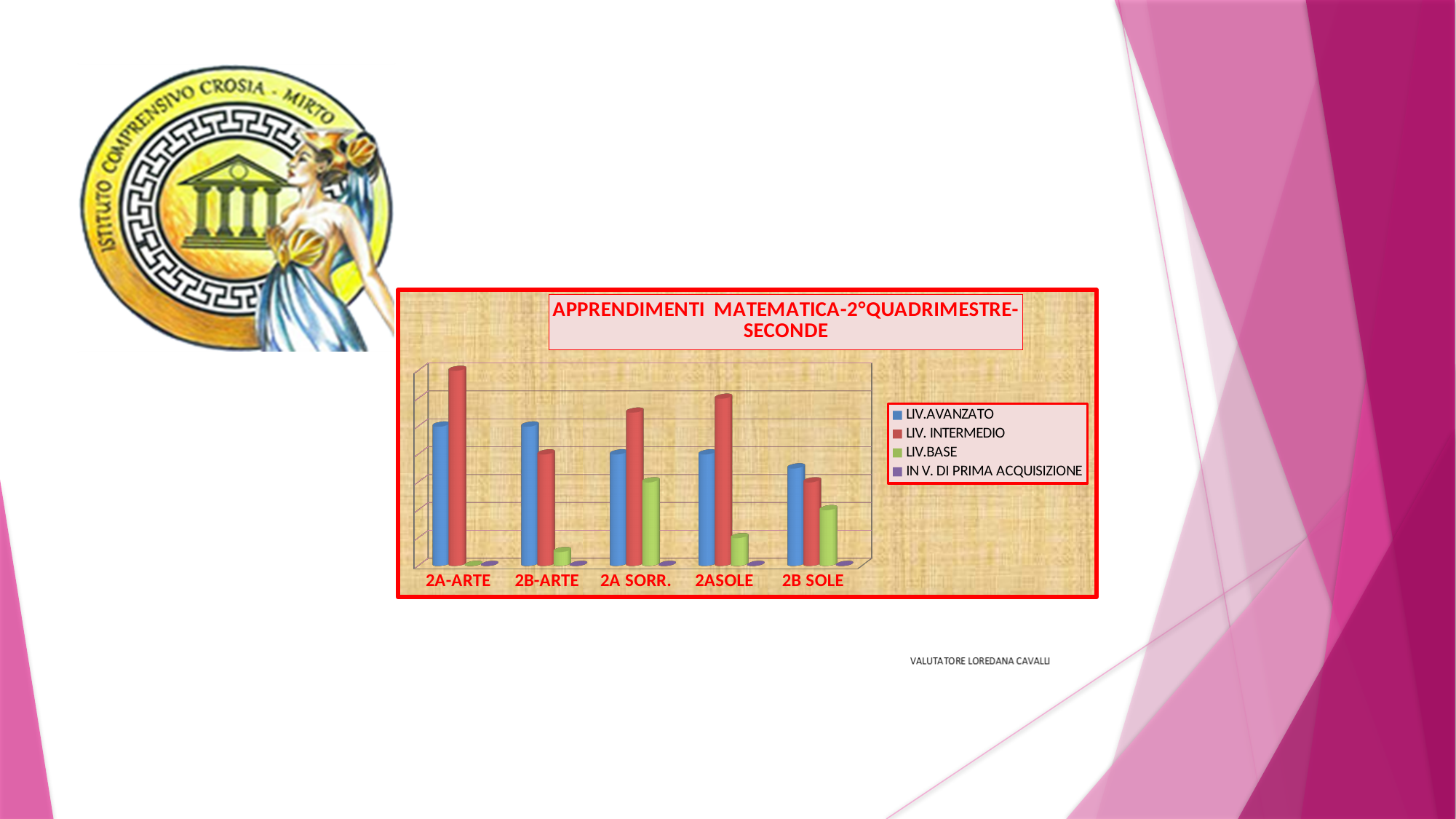
In 2A-ARTE, which is larger: LIV.AVANZATO or LIV. INTERMEDIO? LIV. INTERMEDIO Which category has the lowest value for LIV.AVANZATO? 2B SOLE Which series is shown in green in the chart? LIV.BASE Is the LIV.BASE value for 2A SORR. larger or smaller than the LIV.BASE value for 2B-ARTE? Larger What kind of chart is shown on the slide? Bar chart Which category has the highest value for LIV.BASE? 2A SORR. Which category has the highest value for LIV. INTERMEDIO? 2A-ARTE In 2B-ARTE, which is larger: LIV.AVANZATO or LIV. INTERMEDIO? LIV.AVANZATO How many series does the chart's legend list? 4 Which category has the lowest value for LIV. INTERMEDIO? 2B SOLE What is the title of the chart? APPRENDIMENTI MATEMATICA-2°QUADRIMESTRE-SECONDE How many categories are shown along the x axis of the chart? 5